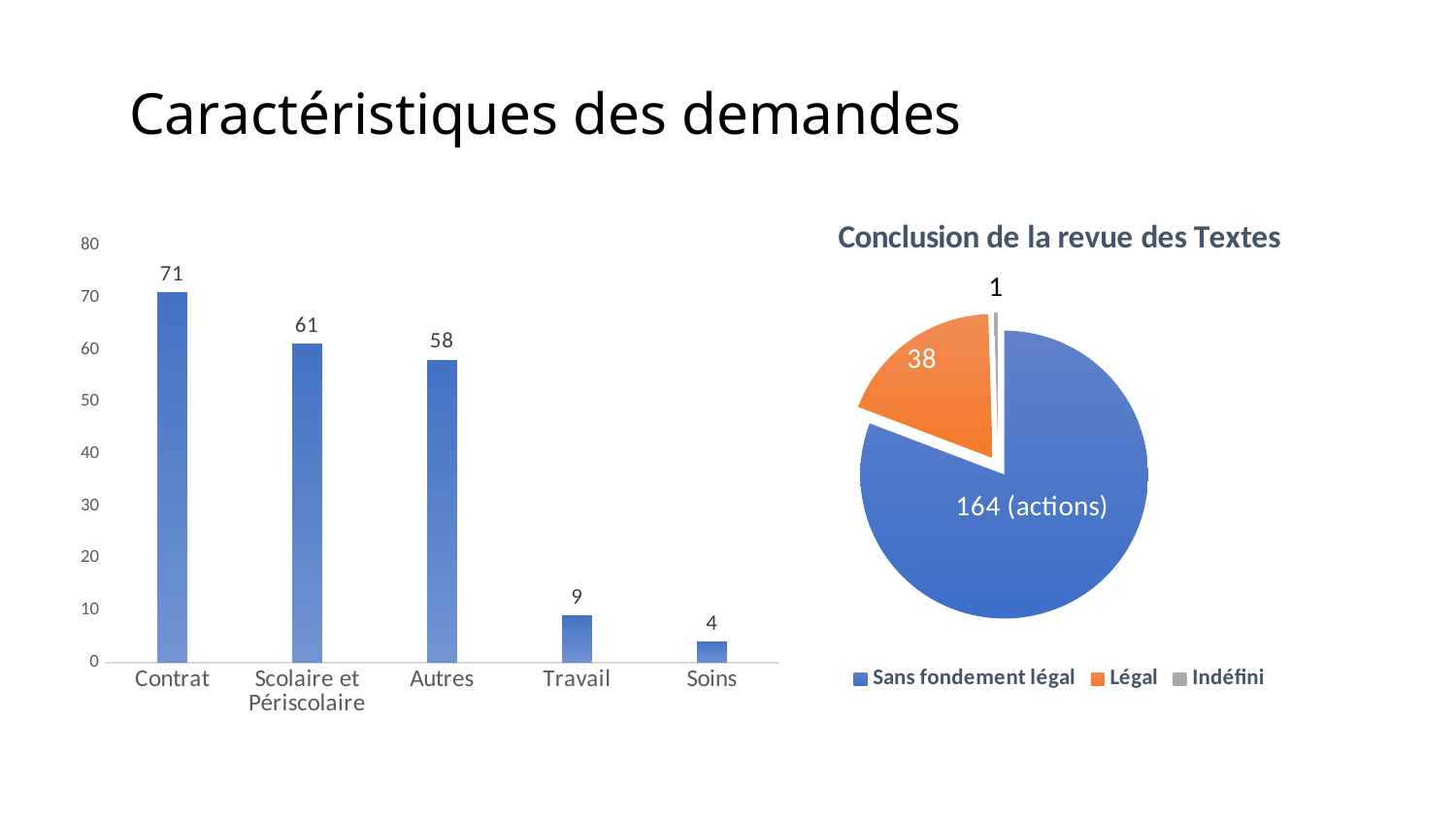
In the bar chart on the left, what is the value for Scolaire et Périscolaire? 61 In the bar chart on the left, which category has the highest value? Contrat In the pie chart 'Conclusion de la revue des Textes', what is the value for Sans fondement légal? 164 (actions) How many entries does the legend of the pie chart 'Conclusion de la revue des Textes' list? 3 What kind of chart is the chart on the left of the slide? Bar chart How many categories are shown in the bar chart on the left? 5 In the bar chart on the left, what is the difference between the values for Contrat and Autres? 13 In the bar chart on the left, what is the value for Contrat? 71 In the bar chart on the left, which category has the lowest value? Soins In the pie chart 'Conclusion de la revue des Textes', what is the value for Légal? 38 In the bar chart on the left, which is larger, the value for Scolaire et Périscolaire or the value for Autres? Scolaire et Périscolaire In the bar chart on the left, what is the value for Travail? 9